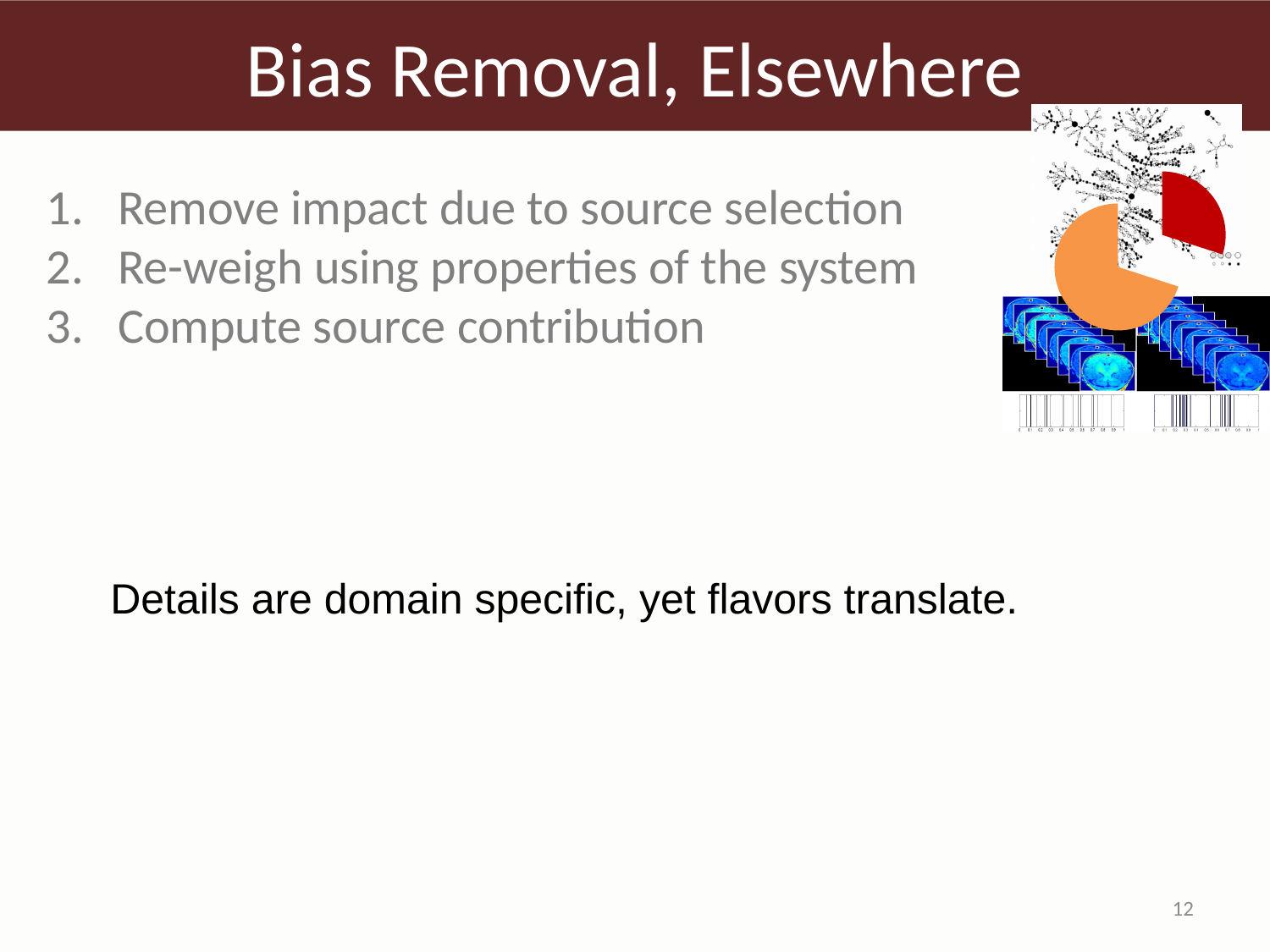
In the pie chart on the right side of the slide, which slice is the largest? the orange slice In the pie chart on the right side of the slide, which slice is the smallest? the red slice In the pie chart on the right side of the slide, which slice is larger, the orange one or the red one? orange How many slices does the pie chart on the right side of the slide have? 2 Does the pie chart on the right side of the slide show a legend? No What two colours are used for the slices of the pie chart on the right side of the slide? orange and red What kind of chart is the chart with the orange and red slices on the right side of the slide? pie chart